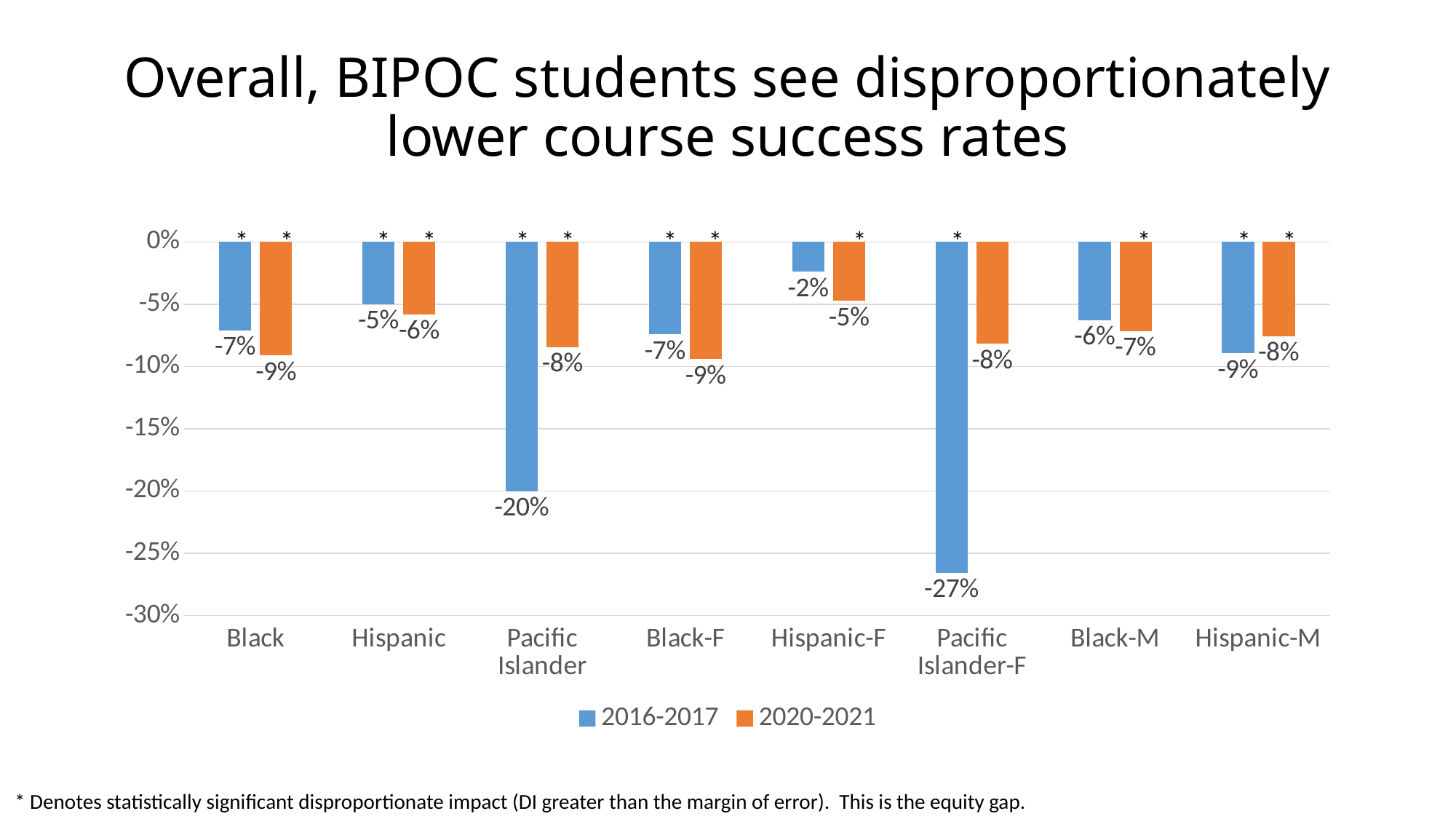
Which colour represents the 2020-2021 series? Orange Which category has the highest (least negative) 2016-2017 value? Hispanic-F How many categories are shown on the x axis? 8 What is the difference between the 2016-2017 and 2020-2021 values for Pacific Islander-F? 19 percentage points Which is lower for Black-F: the 2016-2017 value or the 2020-2021 value? 2020-2021 What kind of chart is shown on the slide? Bar chart How many series does the legend list? 2 What is the 2016-2017 value for Pacific Islander? -20% What is the 2016-2017 value for Hispanic-F? -2% Which category has the lowest 2016-2017 value? Pacific Islander-F What is the 2020-2021 value for Hispanic-M? -8% What is the 2020-2021 value for Black? -9%